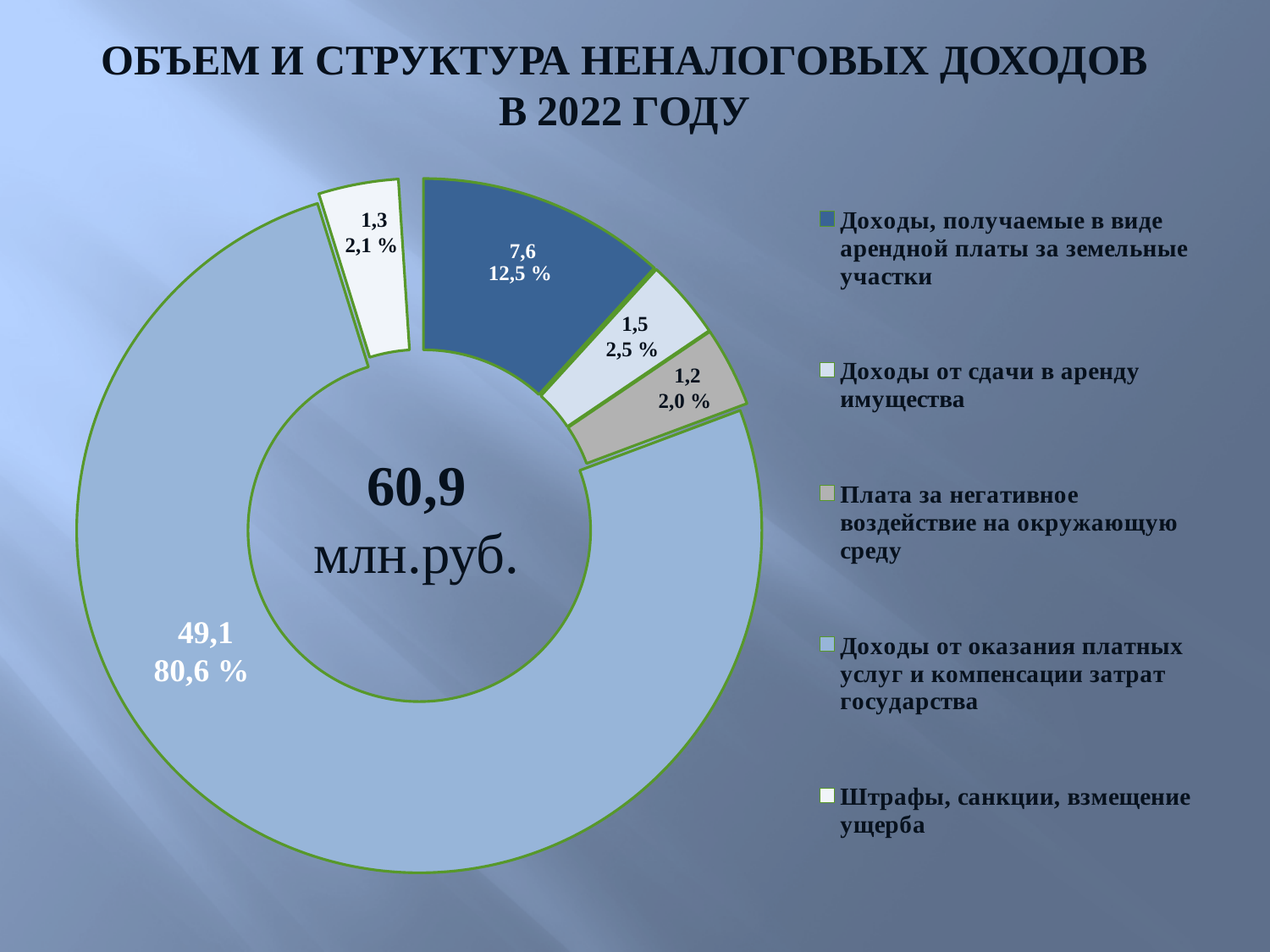
How many categories does the legend list? 5 What is the value for «Плата за негативное воздействие на окружающую среду»? 1,2 What is the value (in млн.руб.) for «Доходы, получаемые в виде арендной платы за земельные участки»? 7,6 Which category has the smallest share? Плата за негативное воздействие на окружающую среду Which category has the largest share of non-tax revenues? Доходы от оказания платных услуг и компенсации затрат государства What share of the total is «Доходы от оказания платных услуг и компенсации затрат государства»? 80,6 % What type of chart is shown on the slide? Doughnut (pie) chart Which is larger: «Штрафы, санкции, взмещение ущерба» or «Плата за негативное воздействие на окружающую среду»? Штрафы, санкции, взмещение ущерба What is the difference between the values for «Доходы, получаемые в виде арендной платы за земельные участки» and «Доходы от сдачи в аренду имущества»? 6,1 What total amount is shown in the centre of the chart? 60,9 млн.руб. What percentage is shown for «Штрафы, санкции, взмещение ущерба»? 2,1 % What is the value for «Доходы от сдачи в аренду имущества»? 1,5